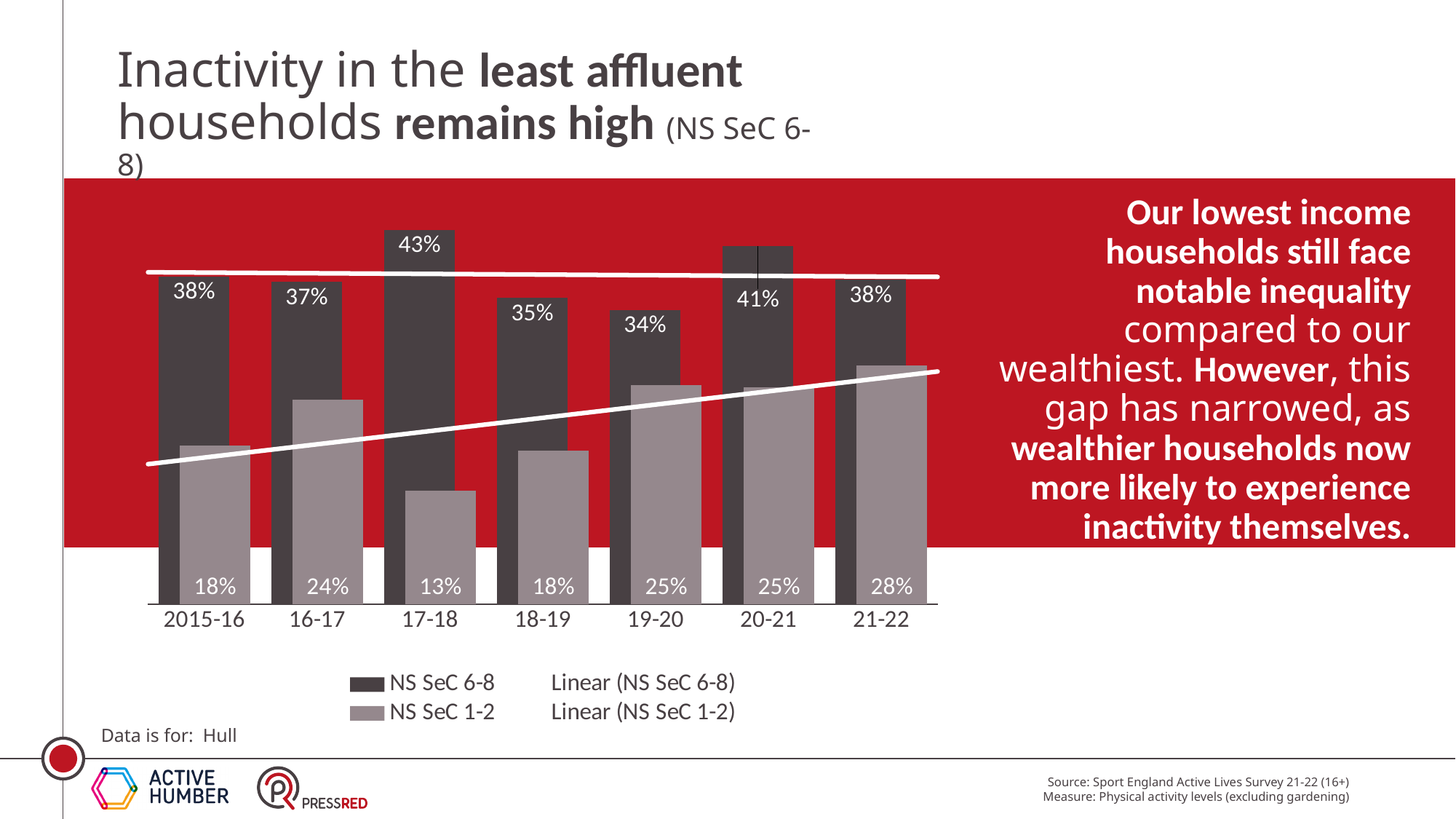
Which area is the data for, according to the slide? Hull How many years are shown on the x axis? 7 Which year has the highest value for NS SeC 6-8? 17-18 What kind of chart is shown? Bar chart What is the difference between NS SeC 6-8 and NS SeC 1-2 in 17-18? 30% What is the value for NS SeC 6-8 in 17-18? 43% Which year has the lowest value for NS SeC 1-2? 17-18 What is the value for NS SeC 1-2 in 21-22? 28% Which is larger in 20-21: NS SeC 6-8 or NS SeC 1-2? NS SeC 6-8 What is the difference between NS SeC 6-8 and NS SeC 1-2 in 21-22? 10% What is the value for NS SeC 1-2 in 2015-16? 18% How many entries does the legend list? 4